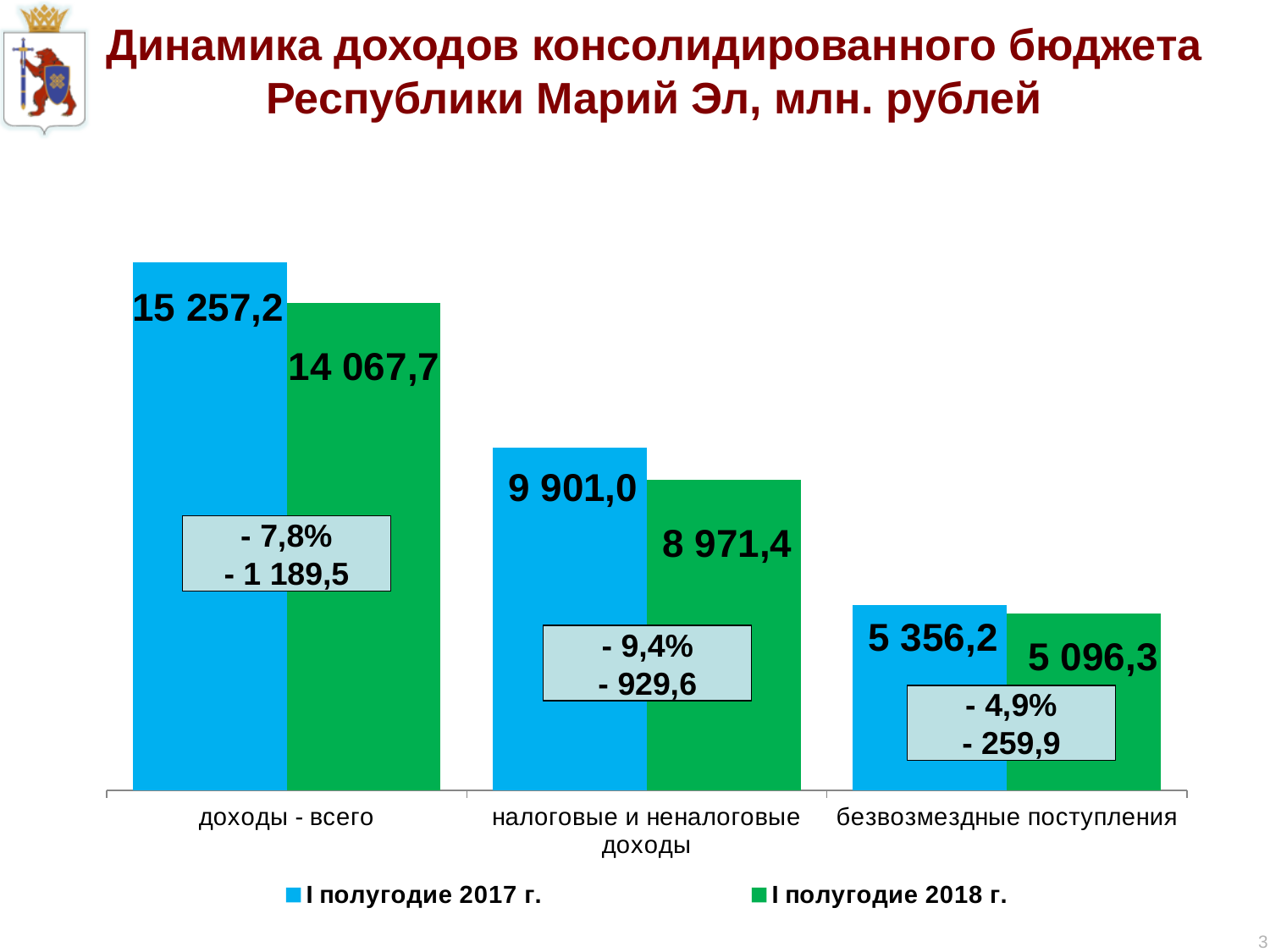
How many series does the legend list? 2 What is the difference between the "I полугодие 2017 г." and "I полугодие 2018 г." values for "безвозмездные поступления"? 259,9 What is the difference between the "I полугодие 2017 г." and "I полугодие 2018 г." values for "налоговые и неналоговые доходы"? 929,6 What kind of chart is shown on the slide? bar chart What is the value for "безвозмездные поступления" in the "I полугодие 2017 г." series? 5 356,2 How many categories are shown on the x axis? 3 Which is larger for "доходы - всего": the "I полугодие 2017 г." value or the "I полугодие 2018 г." value? I полугодие 2017 г. Which category has the highest value in the "I полугодие 2017 г." series? доходы - всего What is the value for "налоговые и неналоговые доходы" in the "I полугодие 2018 г." series? 8 971,4 What is the value for "доходы - всего" in the "I полугодие 2017 г." series? 15 257,2 What is the value for "доходы - всего" in the "I полугодие 2018 г." series? 14 067,7 Which category has the lowest value in the "I полугодие 2018 г." series? безвозмездные поступления